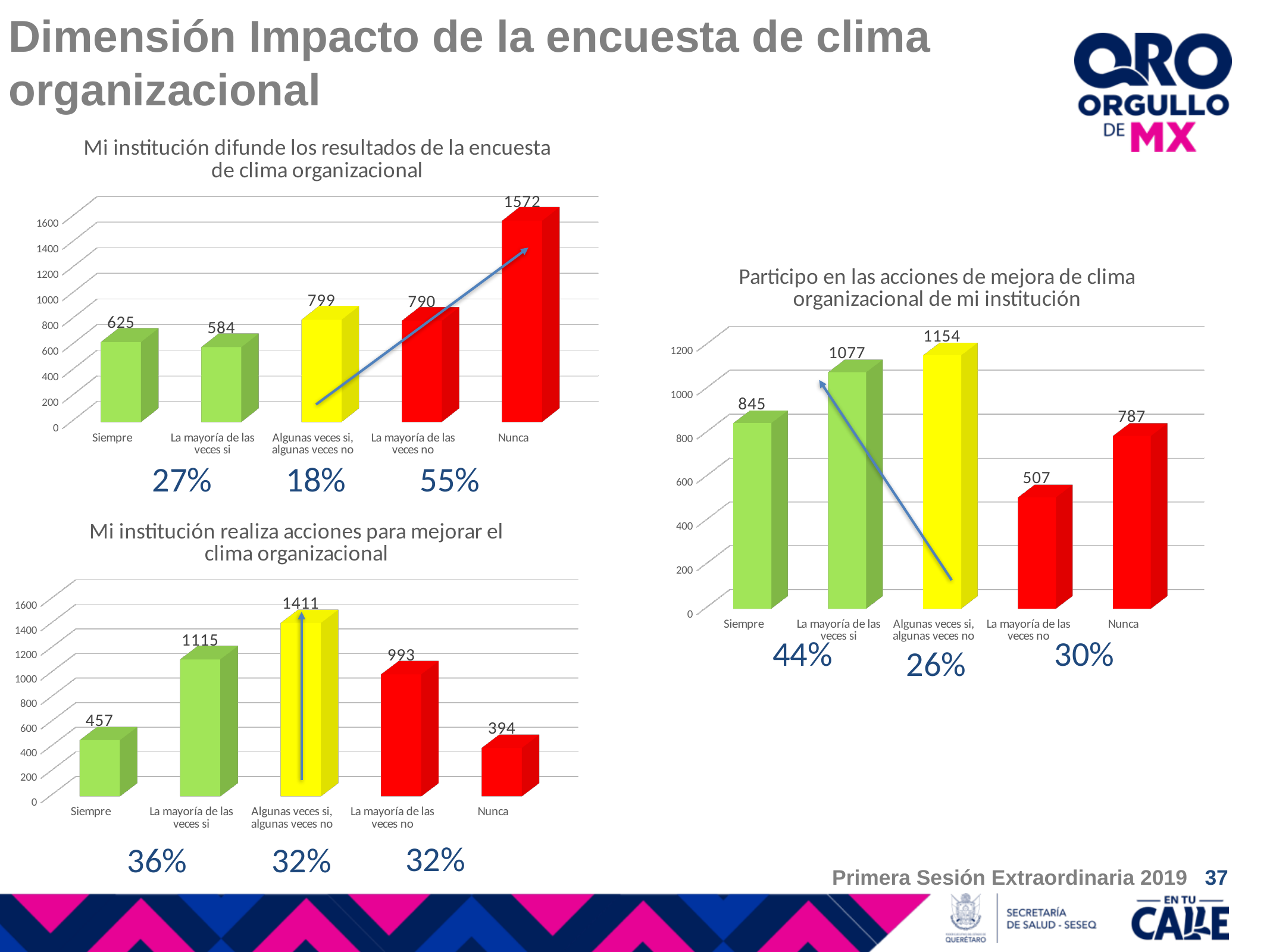
In the chart titled 'Mi institución realiza acciones para mejorar el clima organizacional', which category has the lowest value? Nunca In the chart titled 'Mi institución realiza acciones para mejorar el clima organizacional', what is the value for 'Algunas veces si, algunas veces no'? 1411 How many categories are shown in the chart titled 'Participo en las acciones de mejora de clima organizacional de mi institución'? 5 In the chart titled 'Mi institución difunde los resultados de la encuesta de clima organizacional', what is the value for 'Nunca'? 1572 In the chart titled 'Mi institución realiza acciones para mejorar el clima organizacional', what colour are the bars for 'La mayoría de las veces no' and 'Nunca'? Red In the chart titled 'Participo en las acciones de mejora de clima organizacional de mi institución', which category has the highest value? Algunas veces si, algunas veces no In the chart titled 'Mi institución realiza acciones para mejorar el clima organizacional', which is larger: 'La mayoría de las veces si' or 'La mayoría de las veces no'? La mayoría de las veces si In the chart titled 'Participo en las acciones de mejora de clima organizacional de mi institución', what is the difference between 'Nunca' and 'La mayoría de las veces no'? 280 What kind of chart is the one titled 'Mi institución difunde los resultados de la encuesta de clima organizacional'? Bar chart In the chart titled 'Mi institución difunde los resultados de la encuesta de clima organizacional', which category has the lowest value? La mayoría de las veces si In the chart titled 'Participo en las acciones de mejora de clima organizacional de mi institución', what is the value for 'Siempre'? 845 In the chart titled 'Mi institución difunde los resultados de la encuesta de clima organizacional', what is the difference between 'Nunca' and 'Siempre'? 947